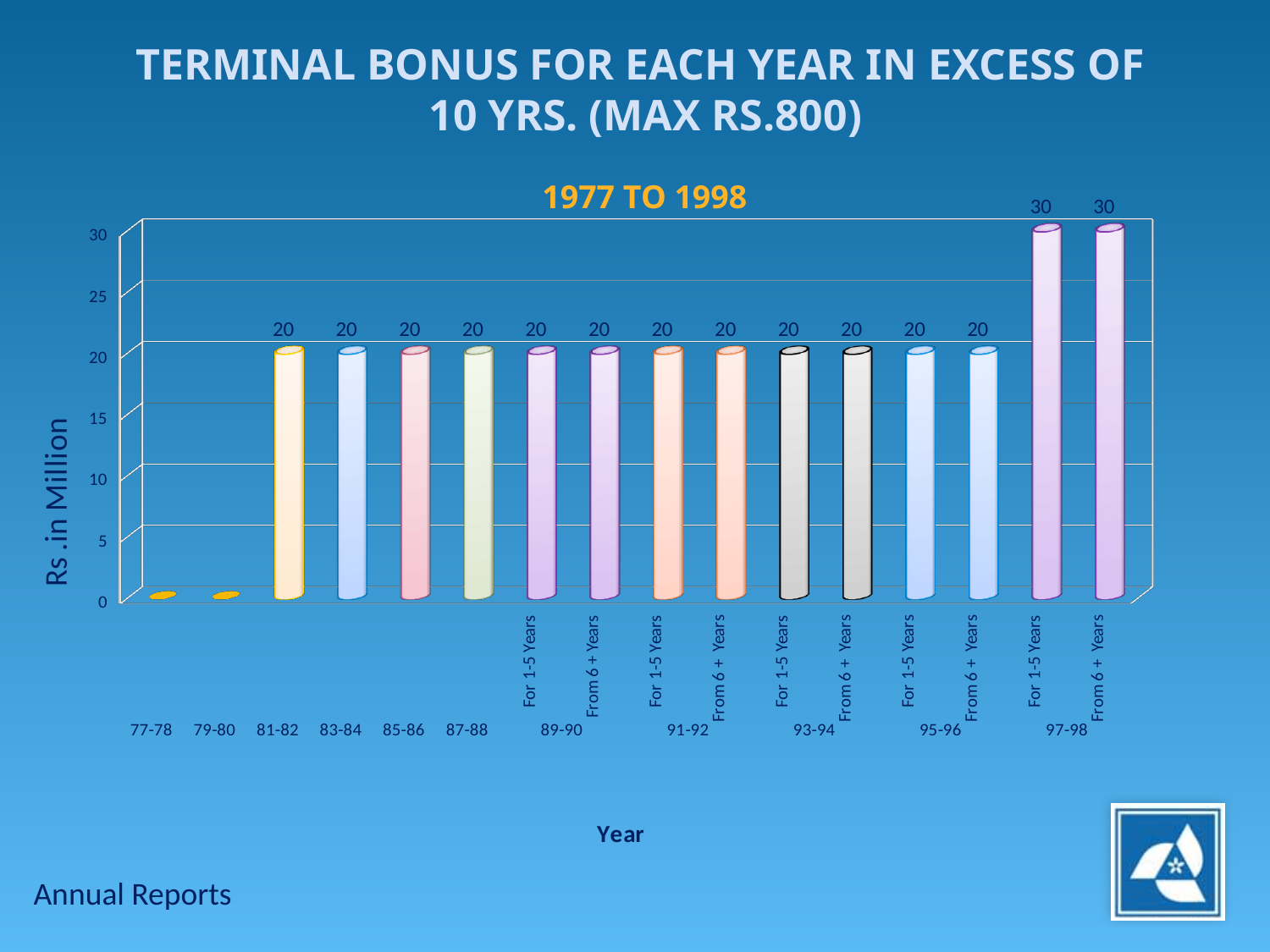
What type of chart is shown on the slide? bar chart What is the value for 97-98 (For 1-5 Years)? 30 Is the value for 85-86 greater or less than 25? less How many year labels are shown on the x axis? 11 Do the values rise or fall from 95-96 to 97-98? rise What is the label of the y axis? Rs .in Million What is the value for 93-94 (From 6 + Years)? 20 What is the value for 81-82? 20 What is the title of the chart? 1977 TO 1998 Which year has the highest value? 97-98 What is the difference between the value for 97-98 (From 6 + Years) and the value for 95-96 (From 6 + Years)? 10 Which is larger, the value for 97-98 (For 1-5 Years) or the value for 89-90 (For 1-5 Years)? 97-98 (For 1-5 Years)